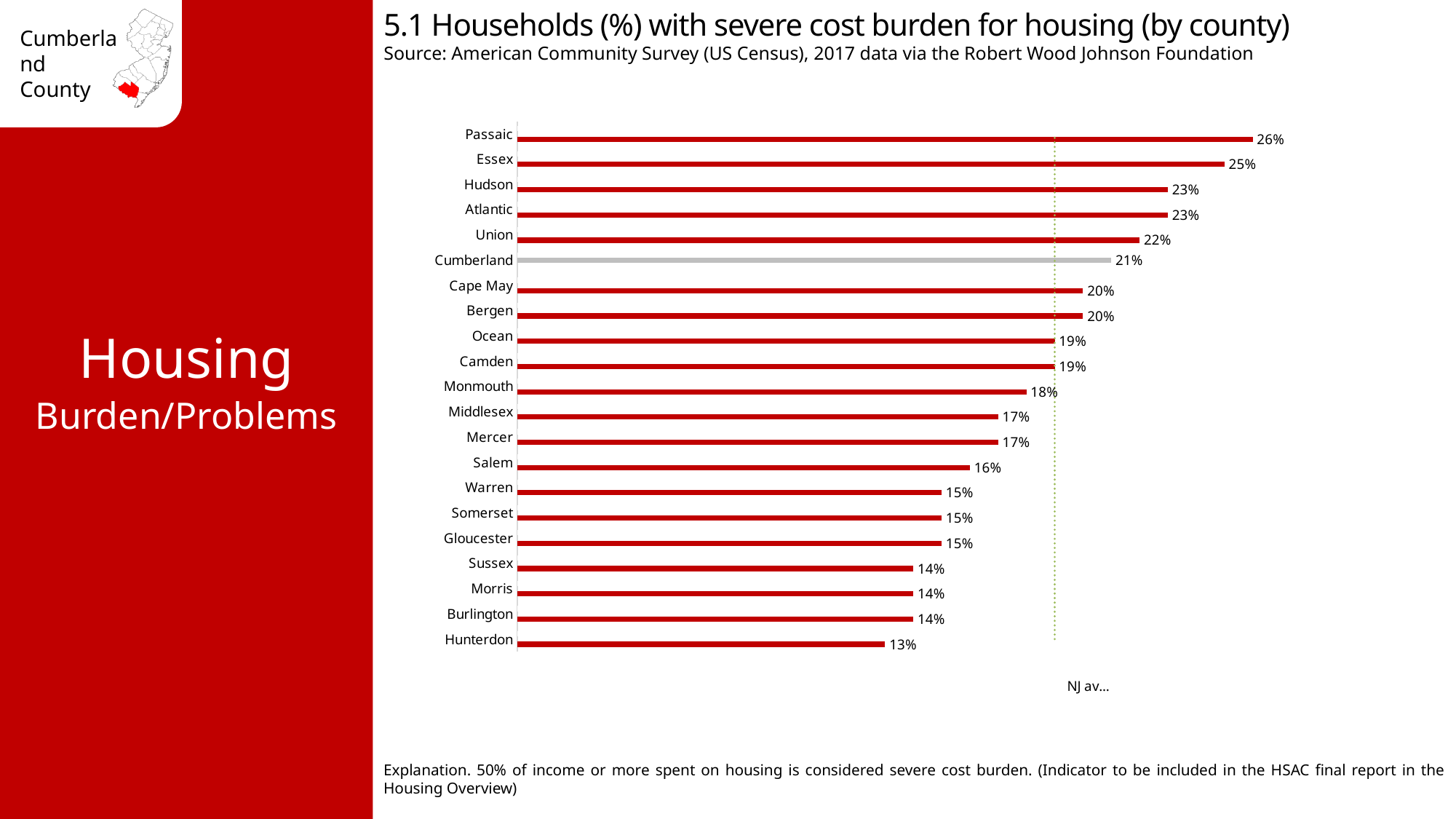
What percentage of households in Cumberland County have a severe housing cost burden? 21% What is the value shown for Salem County? 16% Which county has a higher value, Cape May or Middlesex? Cape May How many percentage points higher is Passaic's value than Cumberland's? 5 percentage points How many counties are shown in the chart? 21 Which county has a higher value, Essex or Union? Essex What is the value shown for Hudson County? 23% What is the difference between the values for Essex and Hunterdon? 12 percentage points Which county has the lowest percentage of households with severe housing cost burden? Hunterdon Which county's bar is shown in grey rather than red? Cumberland Which county has the highest percentage of households with severe housing cost burden? Passaic What type of chart is used on this slide? Bar chart